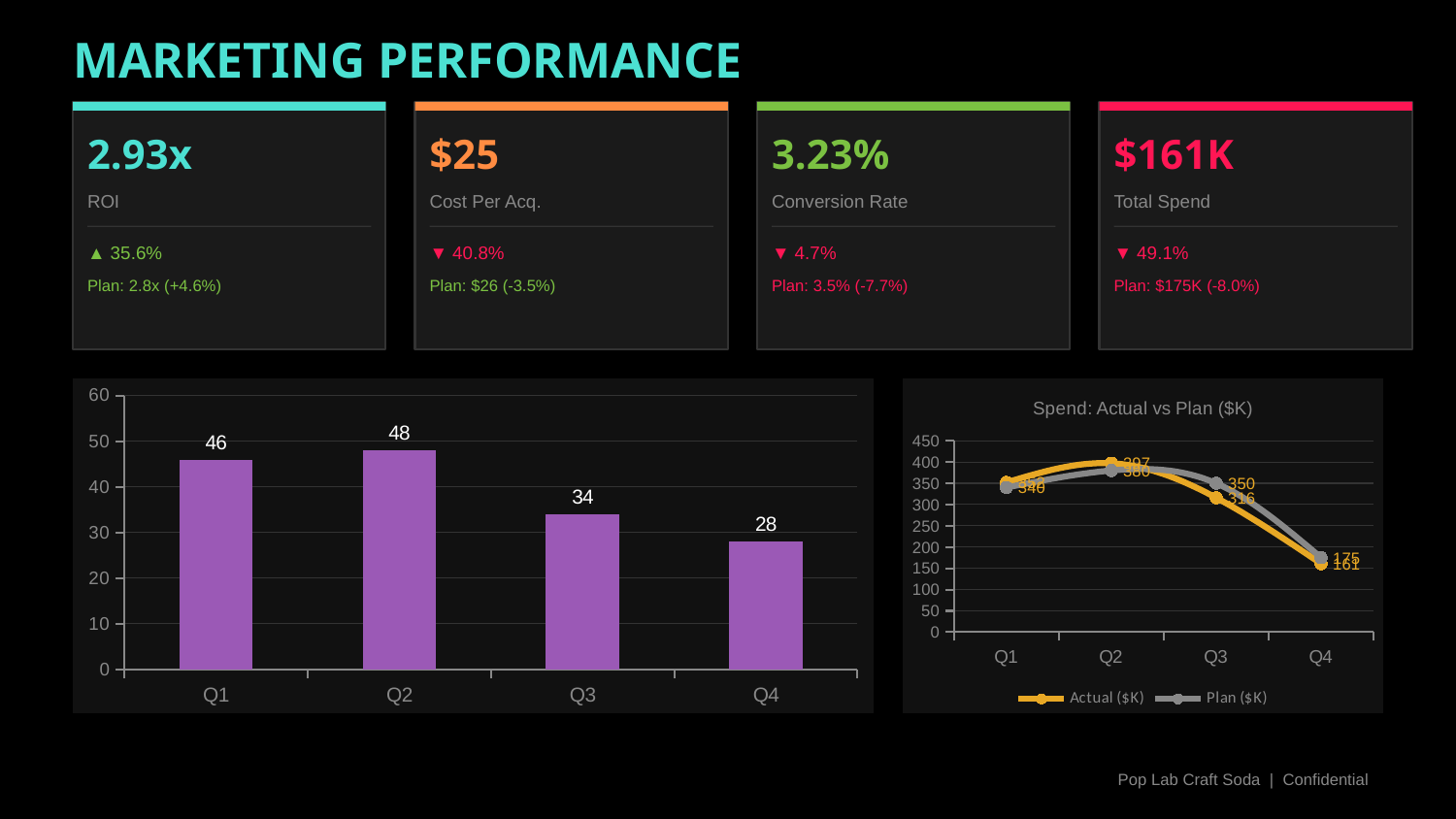
What type of chart is the chart on the left of the slide? bar chart In the 'Spend: Actual vs Plan ($K)' chart, how many series does the legend list? 2 In the bar chart on the left, which quarter has the lowest value? Q4 In the bar chart on the left, how many quarters are plotted? 4 In the 'Spend: Actual vs Plan ($K)' chart, what is the Plan ($K) value for Q4? 175 In the 'Spend: Actual vs Plan ($K)' chart, what is the Actual ($K) value for Q3? 316 In the 'Spend: Actual vs Plan ($K)' chart, is the Actual ($K) value for Q3 larger or smaller than the Plan ($K) value for Q3? smaller In the bar chart on the left, what is the value for Q2? 48 In the bar chart on the left, what is the value for Q4? 28 In the bar chart on the left, is the value for Q3 greater or less than 40? less In the bar chart on the left, which quarter has the highest value? Q2 In the bar chart on the left, what is the difference between the Q1 and Q3 values? 12